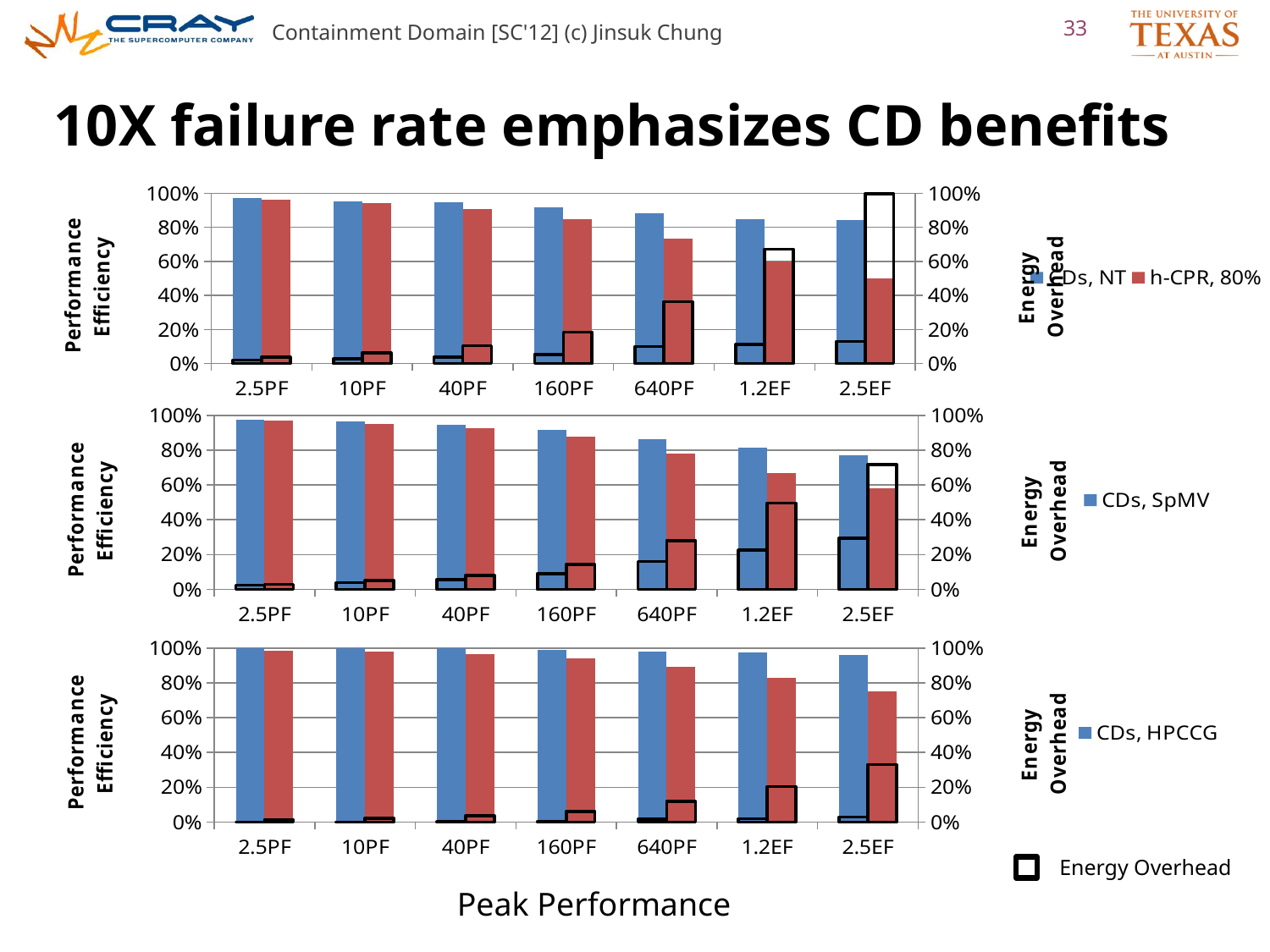
In the top chart (CDs, NT), is the performance efficiency of the CDs bar at 2.5EF greater or less than 80%? greater In the top chart (CDs, NT), is the performance efficiency of the h-CPR, 80% bar at 640PF greater or less than 60%? greater What is the x-axis title shared by the three charts? Peak Performance What kind of chart is the top chart (CDs, NT)? bar chart In the top chart (CDs, NT), which is larger at 2.5EF: the CDs bar or the h-CPR, 80% bar? CDs In the top chart (CDs, NT), at which peak performance is the h-CPR, 80% performance efficiency lowest? 2.5EF How many peak performance categories are shown on the x axis of the bottom chart (CDs, HPCCG)? 7 How many series does the legend of the top chart (CDs, NT) list? 2